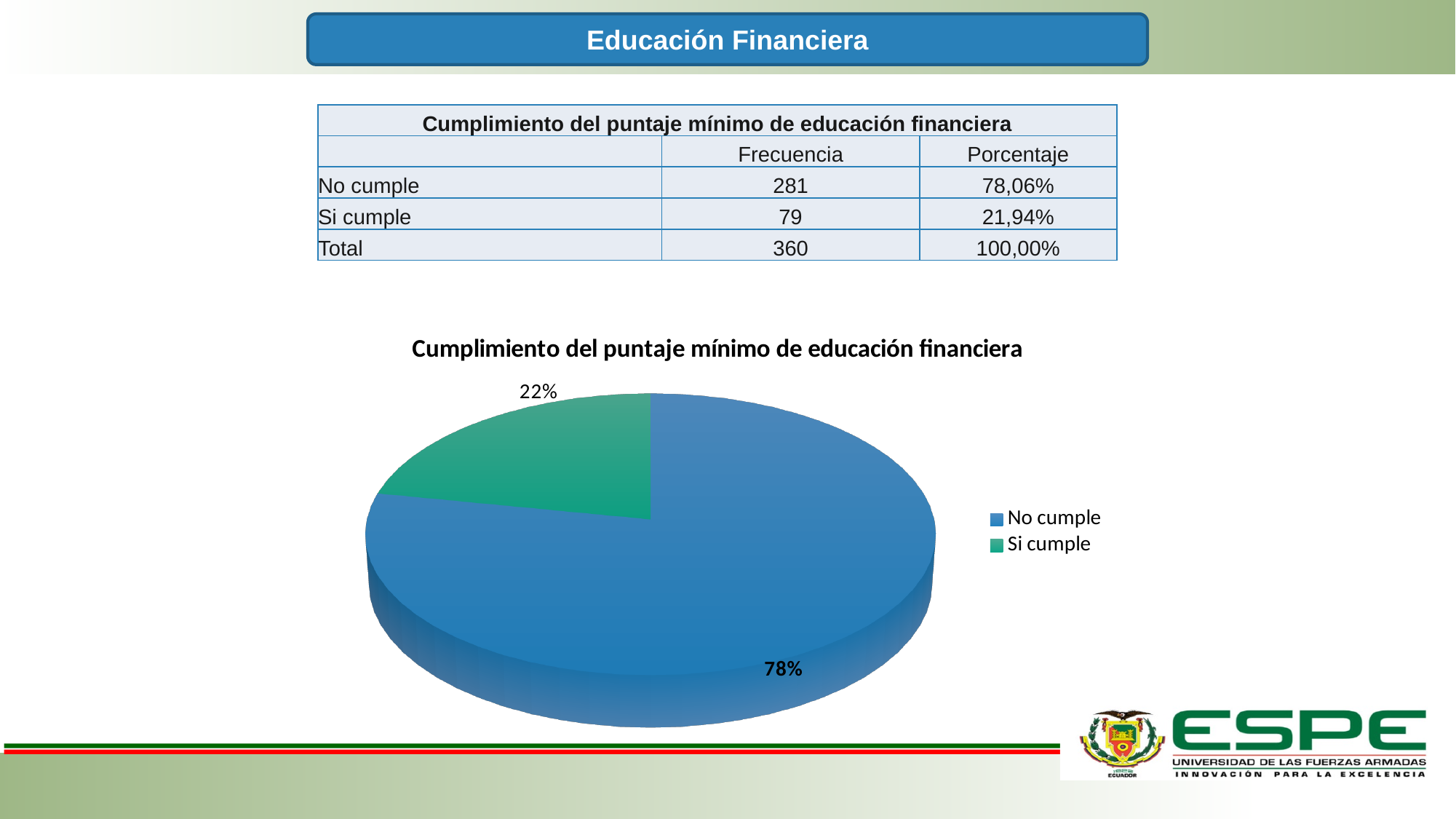
What is the chart's title? Cumplimiento del puntaje mínimo de educación financiera How many entries does the legend list? 2 What percentage does the pie chart show for No cumple? 78% What is the difference in percentage points between the No cumple and Si cumple slices? 56% Which category has the largest slice of the pie? No cumple What percentage does the pie chart show for Si cumple? 22% What kind of chart is shown on the slide? Pie chart How many slices does the pie chart have? 2 Which slice is larger, No cumple or Si cumple? No cumple Which category has the smallest slice of the pie? Si cumple What colour is the Si cumple slice? Green